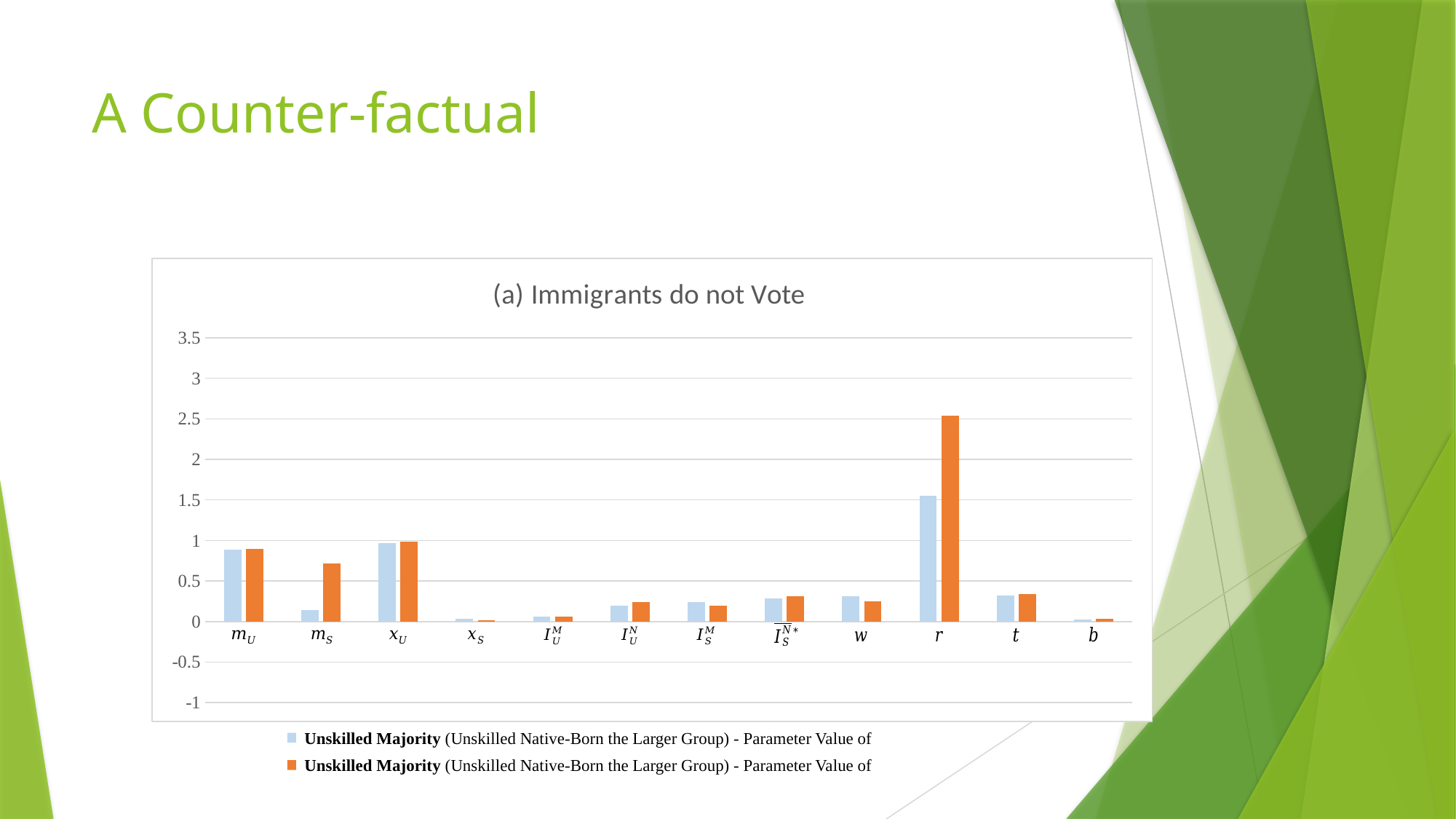
How many series does the chart's legend list? 2 What is the highest value labelled on the vertical axis of the chart? 3.5 Is the light blue bar for r greater or less than 2? less What is the title of the chart? (a) Immigrants do not Vote For the category m_S, which bar is taller, the light blue one or the orange one? orange How many categories are shown along the x axis of the chart? 12 Which category has the tallest bar in the chart? r Is the orange bar for r greater or less than 2? greater For the category r, which bar is taller, the light blue one or the orange one? orange Is the light blue bar for m_S greater or less than 0.5? less What kind of chart is shown on the slide? bar chart